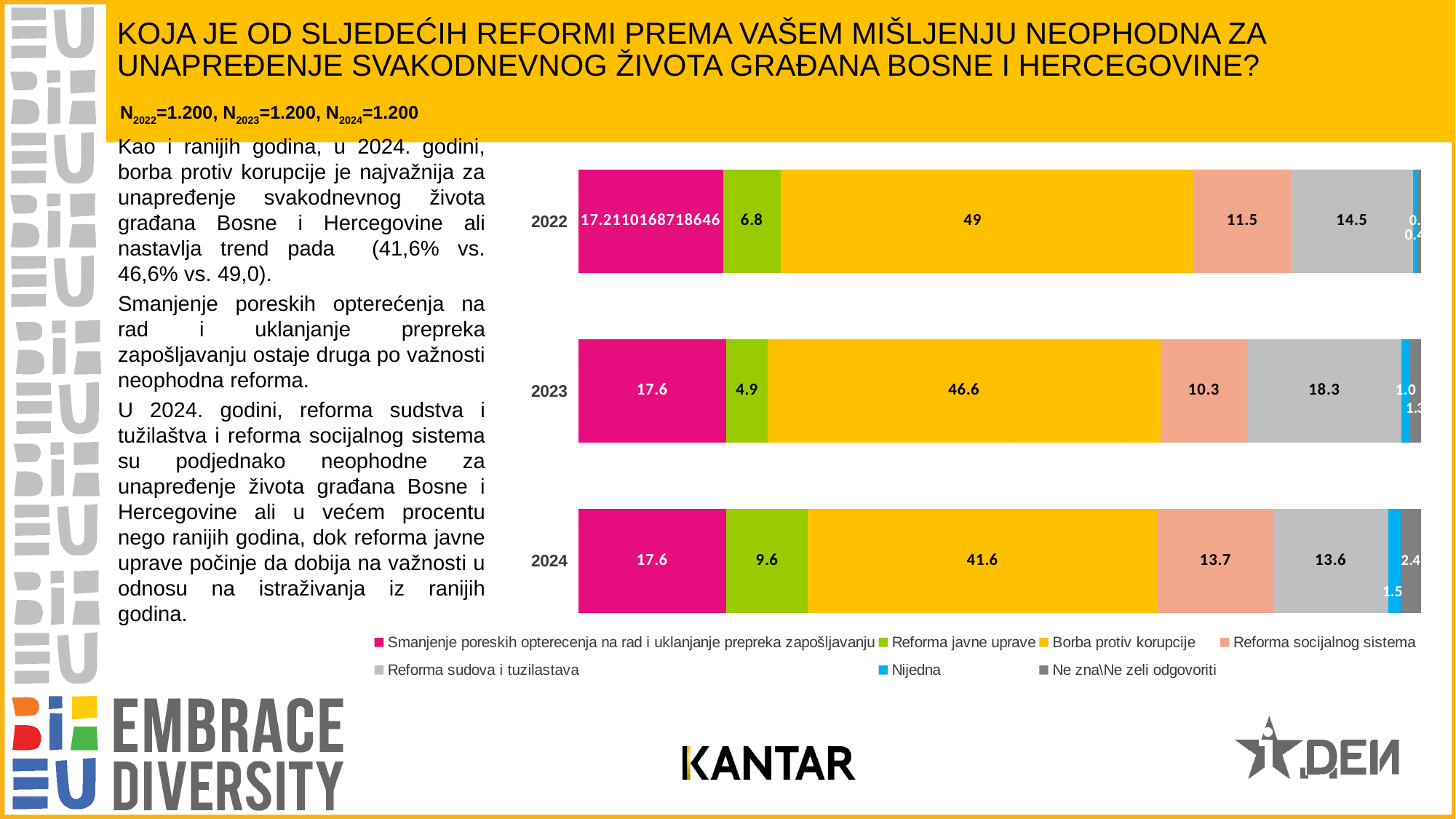
In which year is the value for Reforma javne uprave the lowest? 2023 How many series does the chart legend list? 7 What is the value for Reforma javne uprave in 2023? 4.9 What is the value for Reforma sudova i tuzilastava in 2023? 18.3 Does the value for Borba protiv korupcije rise or fall from 2022 to 2024? Fall Which is larger: the Reforma socijalnog sistema value for 2023 or for 2024? 2024 What kind of chart is shown on the slide? Stacked bar chart What is the difference between the Borba protiv korupcije values for 2022 and 2024? 7.4 What is the value for Reforma socijalnog sistema in 2022? 11.5 In which year is the value for Borba protiv korupcije the highest? 2022 How many years (bars) are shown in the chart? 3 What is the value for Borba protiv korupcije in 2024? 41.6